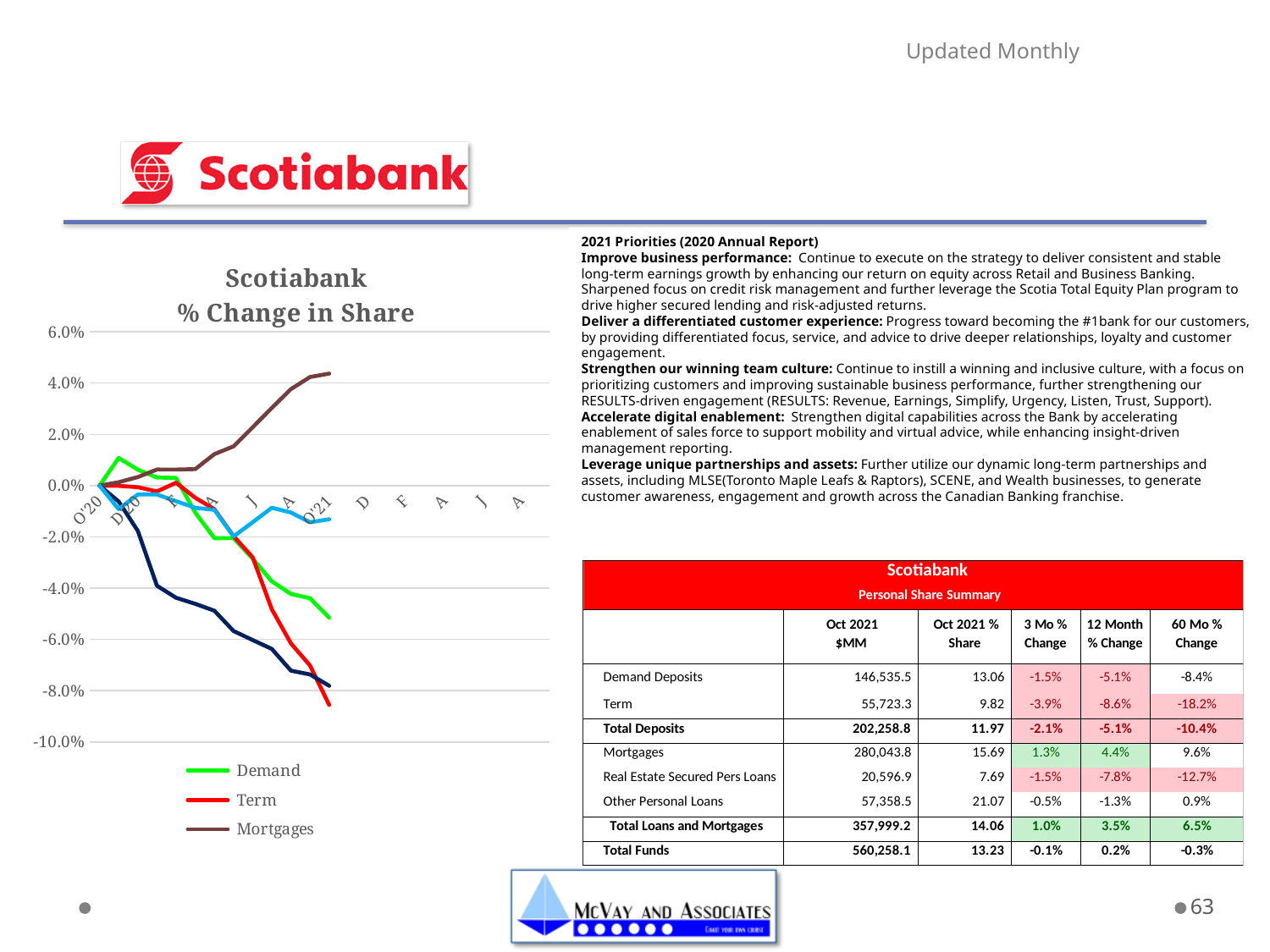
In the "Scotiabank % Change in Share" chart, does the Mortgages line rise or fall from O'20 to O'21? rise How many series does the legend of the "Scotiabank % Change in Share" chart list? 3 In the "Scotiabank % Change in Share" chart, is the value for Mortgages at O'21 greater or less than 2.0%? greater In the "Scotiabank % Change in Share" chart, of Demand, Term and Mortgages, which series has the highest value at O'21? Mortgages In the "Scotiabank % Change in Share" chart, of Demand, Term and Mortgages, which series has the lowest value at O'21? Term In the "Scotiabank % Change in Share" chart, is the value for Demand at O'21 greater or less than -2.0%? less In the "Scotiabank % Change in Share" chart, does the Term line rise or fall from O'20 to O'21? fall In the "Scotiabank % Change in Share" chart, which is higher at O'21, Mortgages or Term? Mortgages What is the title of the chart on the left of the slide? Scotiabank % Change in Share What kind of chart is the "Scotiabank % Change in Share" chart? line chart In the "Scotiabank % Change in Share" chart, what colour is the Mortgages line? brown In the "Scotiabank % Change in Share" chart, is the value for Term at O'21 greater or less than -6.0%? less